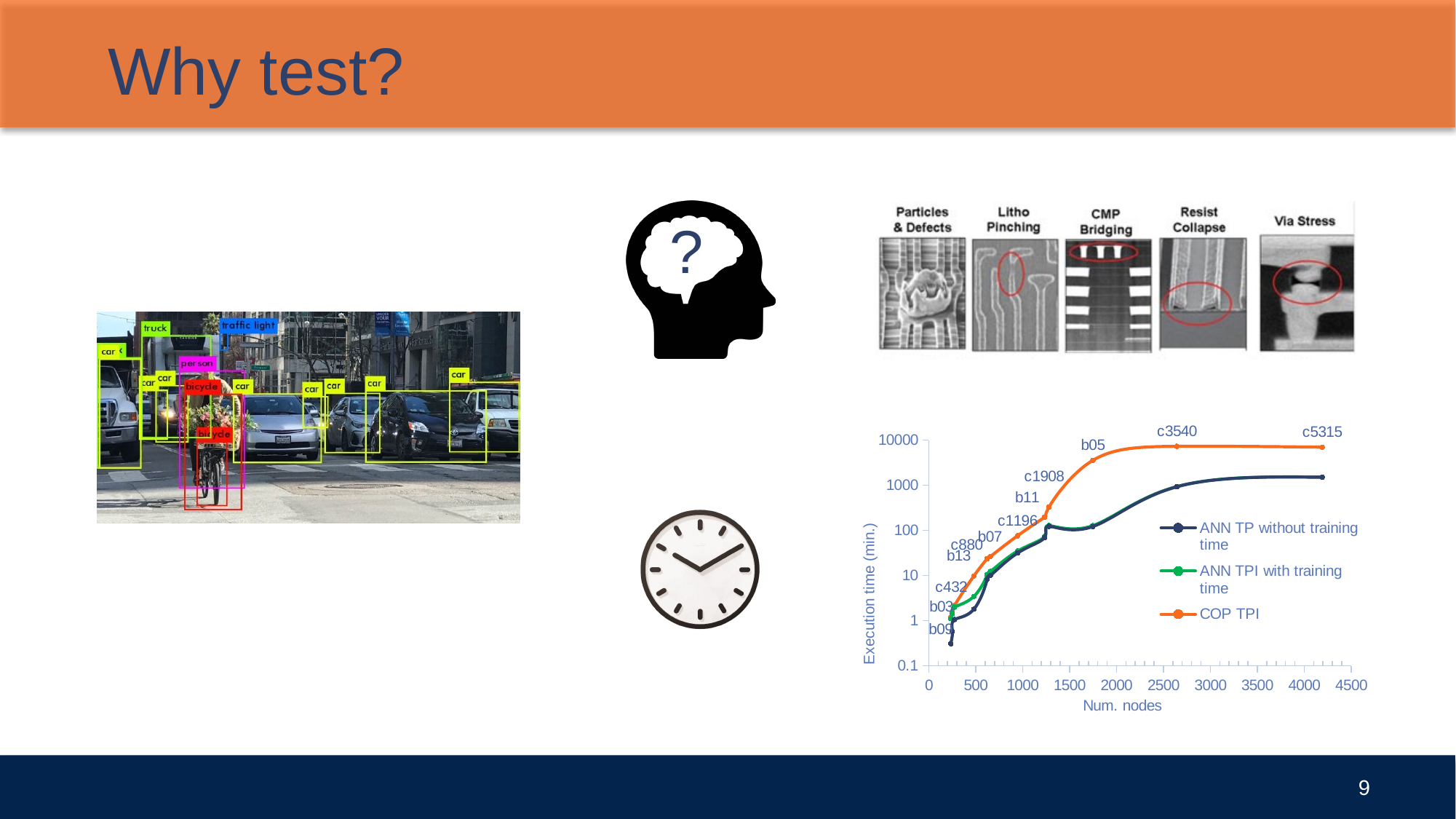
How many series does the chart's legend list? 3 Is the COP TPI value at the point labelled c5315 greater or less than 1000? greater Is the ANN TP without training time value at the point labelled b09 greater or less than 1? less Which series is drawn in orange in the chart? COP TPI Which series reaches the highest execution time on the chart? COP TPI Does execution time generally rise or fall as the number of nodes increases? rise What is the title of the chart's y axis? Execution time (min.) Is the COP TPI value at the point labelled b05 greater or less than 1000? greater What is the title of the chart's x axis? Num. nodes At the largest number of nodes, which series has the higher execution time: COP TPI or ANN TP without training time? COP TPI How many circuit names are labelled on the chart's data points? 12 What kind of chart is shown on the slide? line chart